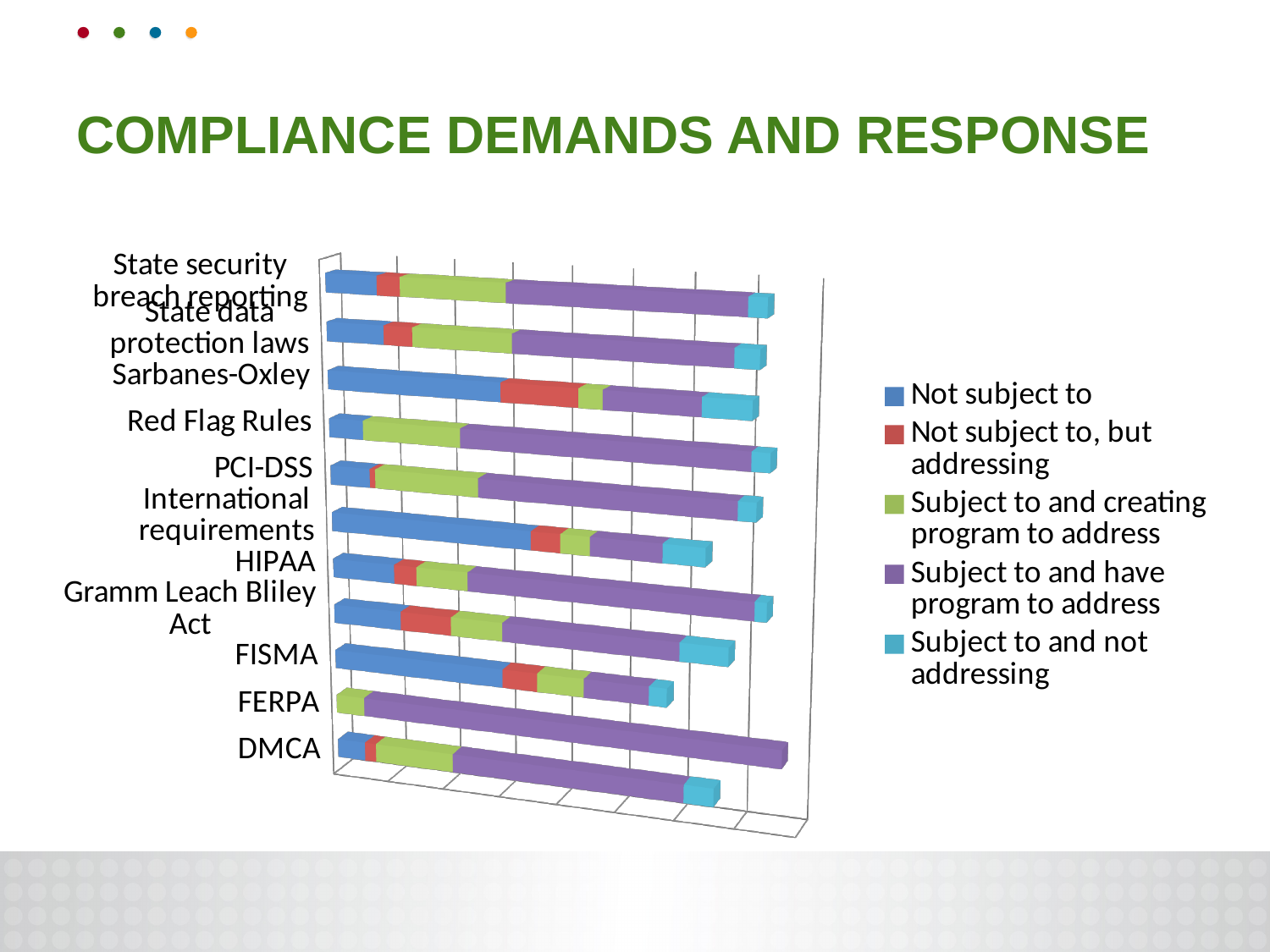
Which category has no 'Not subject to' segment in its bar? FERPA Which legend entry is shown in purple? Subject to and have program to address Which category is listed at the bottom of the chart's vertical axis? DMCA How many series does the chart's legend list? 5 What kind of chart is shown on the slide? Stacked bar chart What is the title of the slide containing the chart? COMPLIANCE DEMANDS AND RESPONSE Which has the larger 'Subject to and creating program to address' segment: DMCA or FERPA? DMCA Which has the larger 'Not subject to' segment: Sarbanes-Oxley or Red Flag Rules? Sarbanes-Oxley How many categories (regulations) are listed on the chart's vertical axis? 11 Which category has the longest 'Subject to and have program to address' segment? FERPA